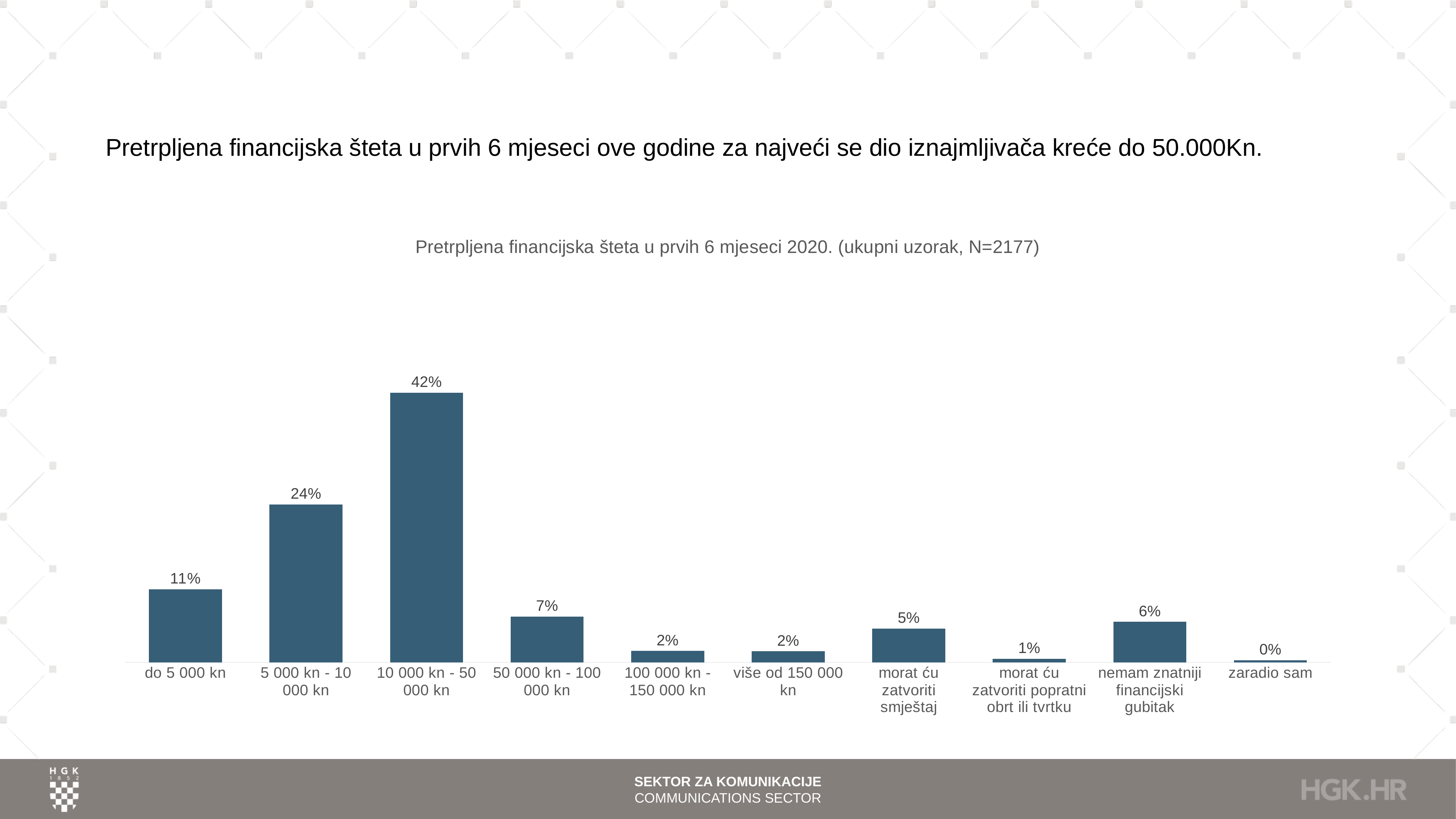
What is the value for the category "do 5 000 kn"? 11% What is the title of the chart? Pretrpljena financijska šteta u prvih 6 mjeseci 2020. (ukupni uzorak, N=2177) How many categories are shown on the x axis? 10 Which category has the highest value? 10 000 kn - 50 000 kn What is the value for "morat ću zatvoriti popratni obrt ili tvrtku"? 1% What is the value for "nemam znatniji financijski gubitak"? 6% Which is larger: the value for "50 000 kn - 100 000 kn" or the value for "morat ću zatvoriti smještaj"? 50 000 kn - 100 000 kn What is the value for the category "10 000 kn - 50 000 kn"? 42% Which category has the lowest value? zaradio sam What is the difference between the values for "10 000 kn - 50 000 kn" and "5 000 kn - 10 000 kn"? 18% What is the total of the values for "100 000 kn - 150 000 kn" and "više od 150 000 kn"? 4% What kind of chart is shown on the slide? Bar chart